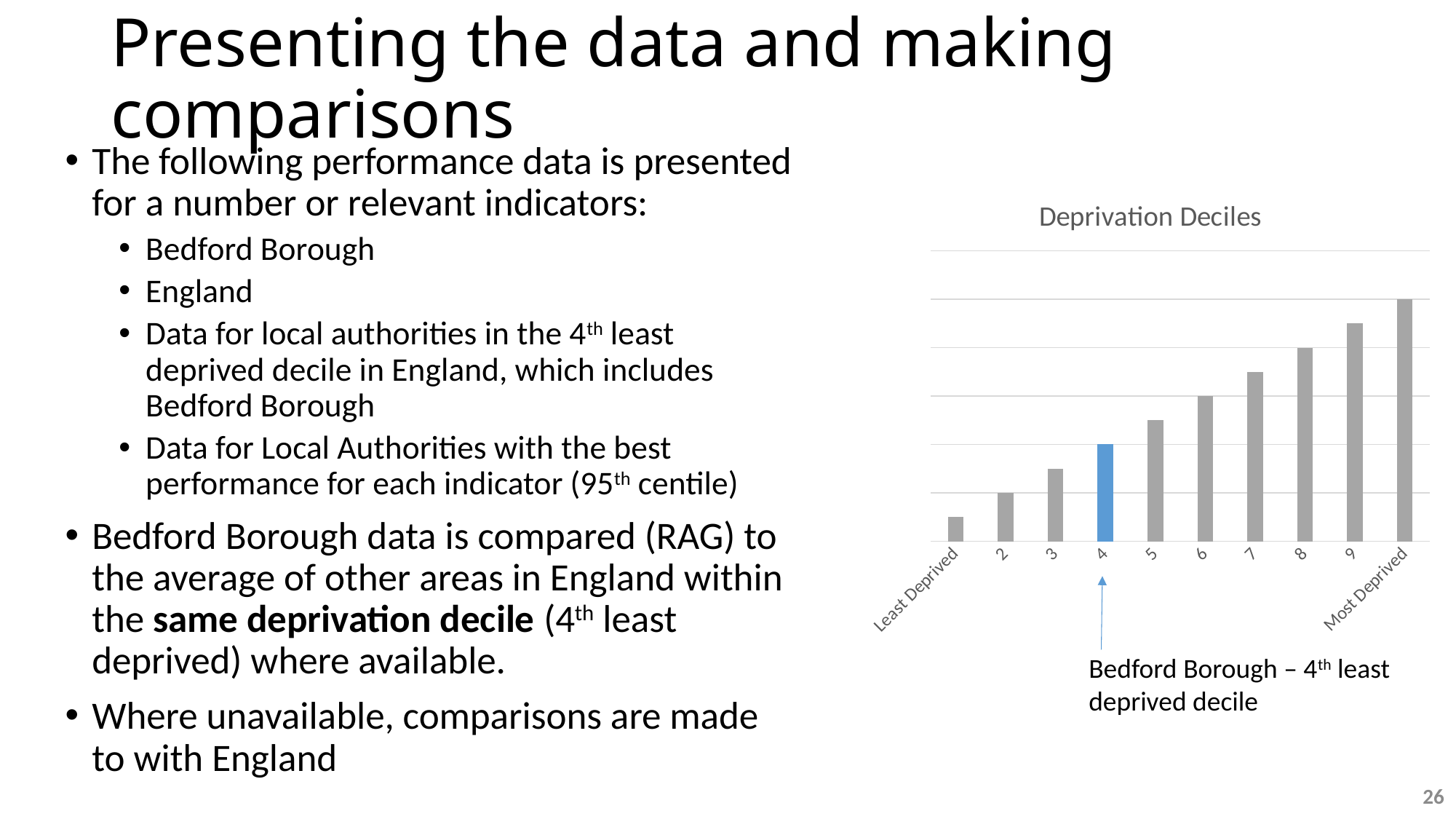
What kind of chart is shown on the slide? Bar chart Do the bars rise or fall moving from Least Deprived to Most Deprived along the x axis? Rise Which bar in the chart is coloured blue rather than grey? 4 How many bars are plotted in the Deprivation Deciles chart? 10 What is the label of the first category on the x axis? Least Deprived Which category has the tallest bar in the Deprivation Deciles chart? Most Deprived Which bar is taller, decile 2 or decile 9? 9 What is the title of the chart? Deprivation Deciles Which category has the shortest bar in the Deprivation Deciles chart? Least Deprived Which bar is shorter, decile 5 or decile 8? 5 What is the label of the last category on the x axis? Most Deprived Which bar is taller, decile 7 or decile 3? 7